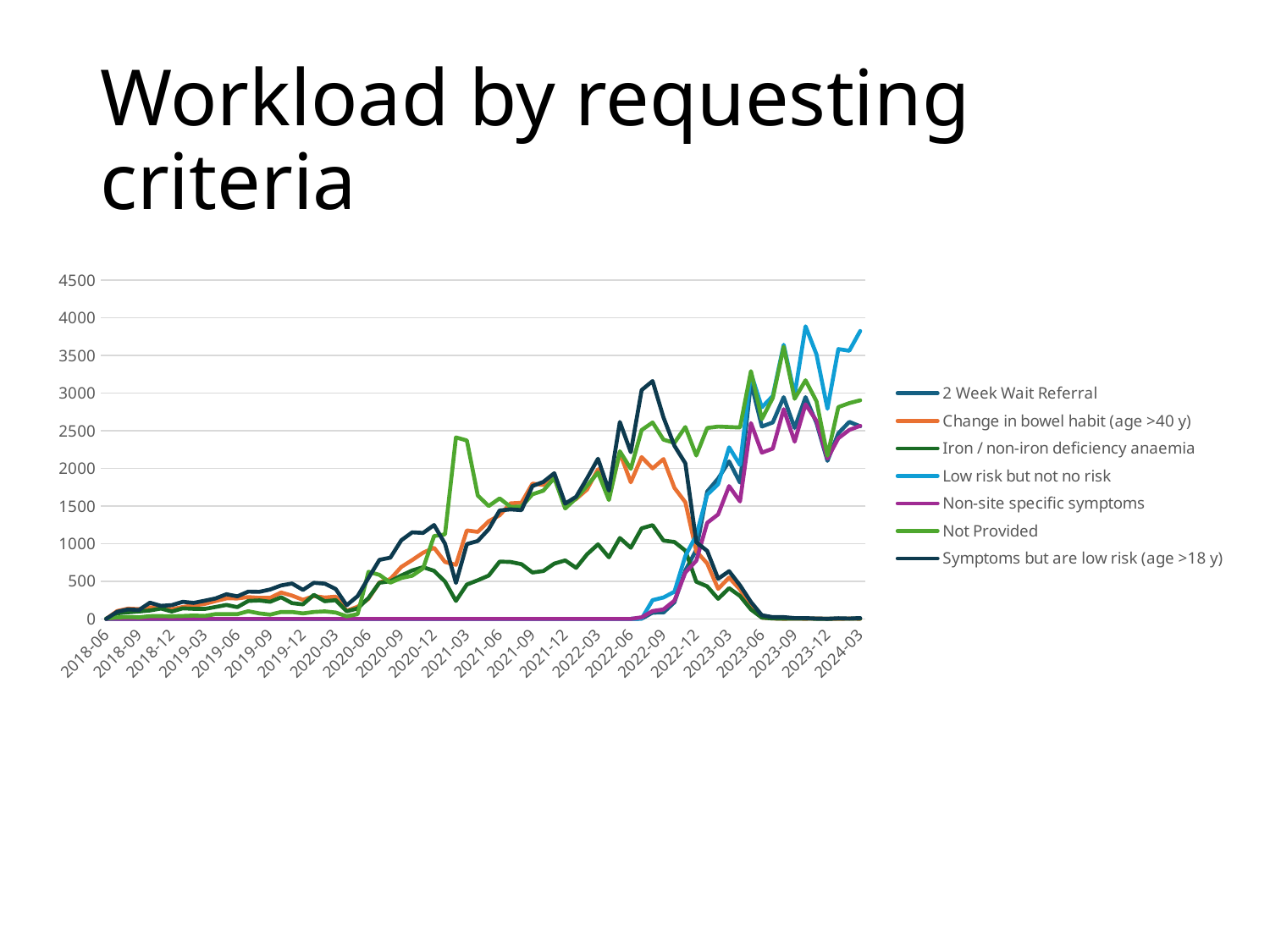
Does the 'Symptoms but are low risk (age >18 y)' series rise or fall between 2022-09 and 2023-06? fall At 2021-03, which is larger: 'Not Provided' or 'Change in bowel habit (age >40 y)'? Not Provided Which series reaches the highest value anywhere on the chart? Low risk but not no risk Is the value of the 'Not Provided' series at 2021-03 greater or less than 2000? greater What is the title of the slide containing the chart? Workload by requesting criteria How many date labels are shown along the x axis? 24 What kind of chart is shown on the slide? line chart Is the peak value of the 'Low risk but not no risk' series around 2023-09 greater or less than 3500? greater How many series does the legend list? 7 Is the value of the 'Non-site specific symptoms' series at 2024-03 greater or less than 2000? greater What is the highest value shown on the vertical axis? 4500